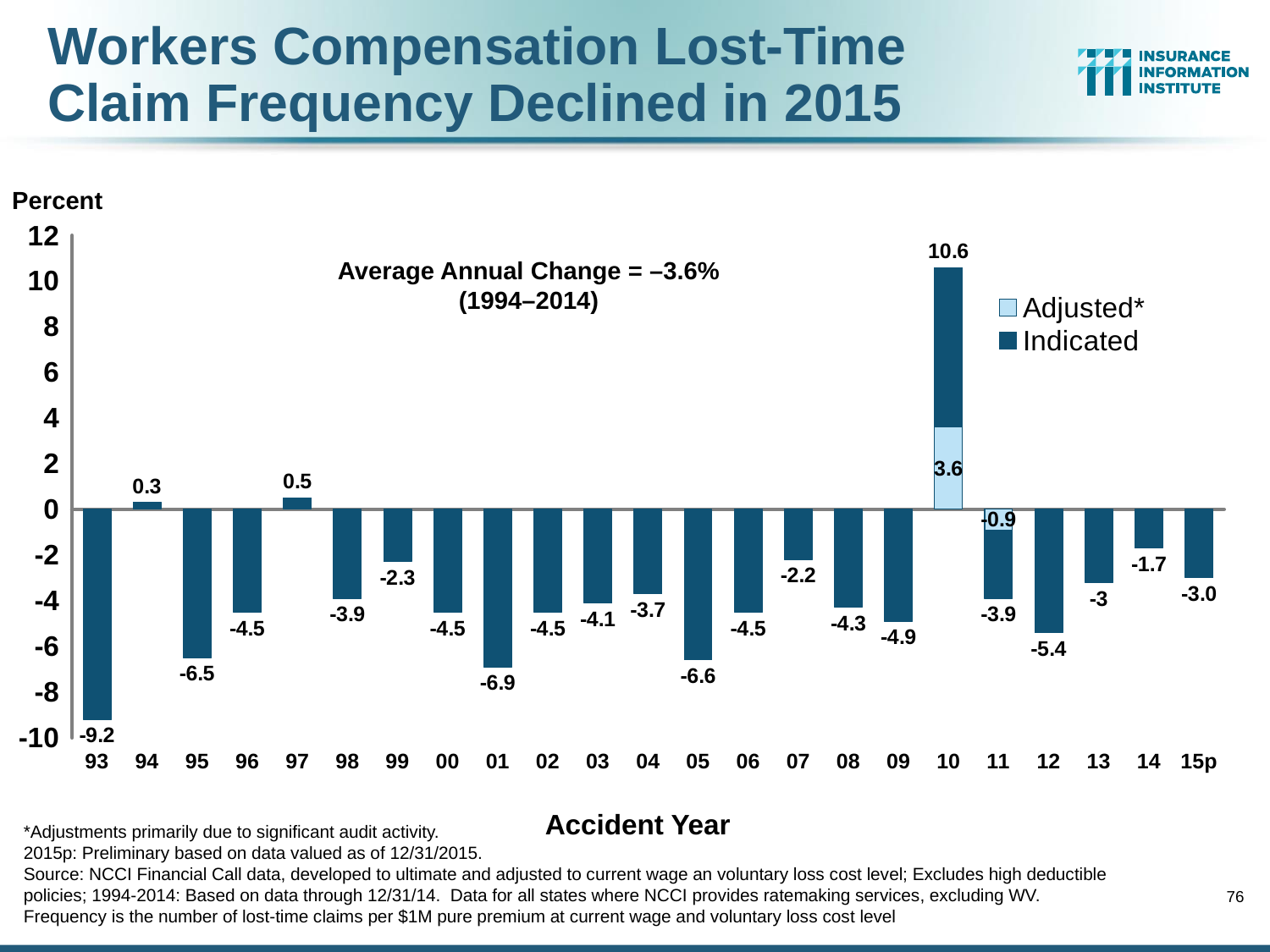
What is the label of the x axis? Accident Year Which accident year has a larger value, 12 or 13? 13 What is the value shown for accident year 93? -9.2 How many accident years are shown on the x axis? 23 What is the Adjusted* value shown for accident year 10? 3.6 Which accident year has the highest value on the chart? 10 What average annual change for 1994–2014 is stated on the chart? –3.6% What kind of chart is shown on the slide? Bar chart What is the difference between the values for accident years 01 and 99? 4.6 How many series does the legend list? 2 What is the value shown for accident year 15p? -3.0 Which accident year has the lowest value on the chart? 93